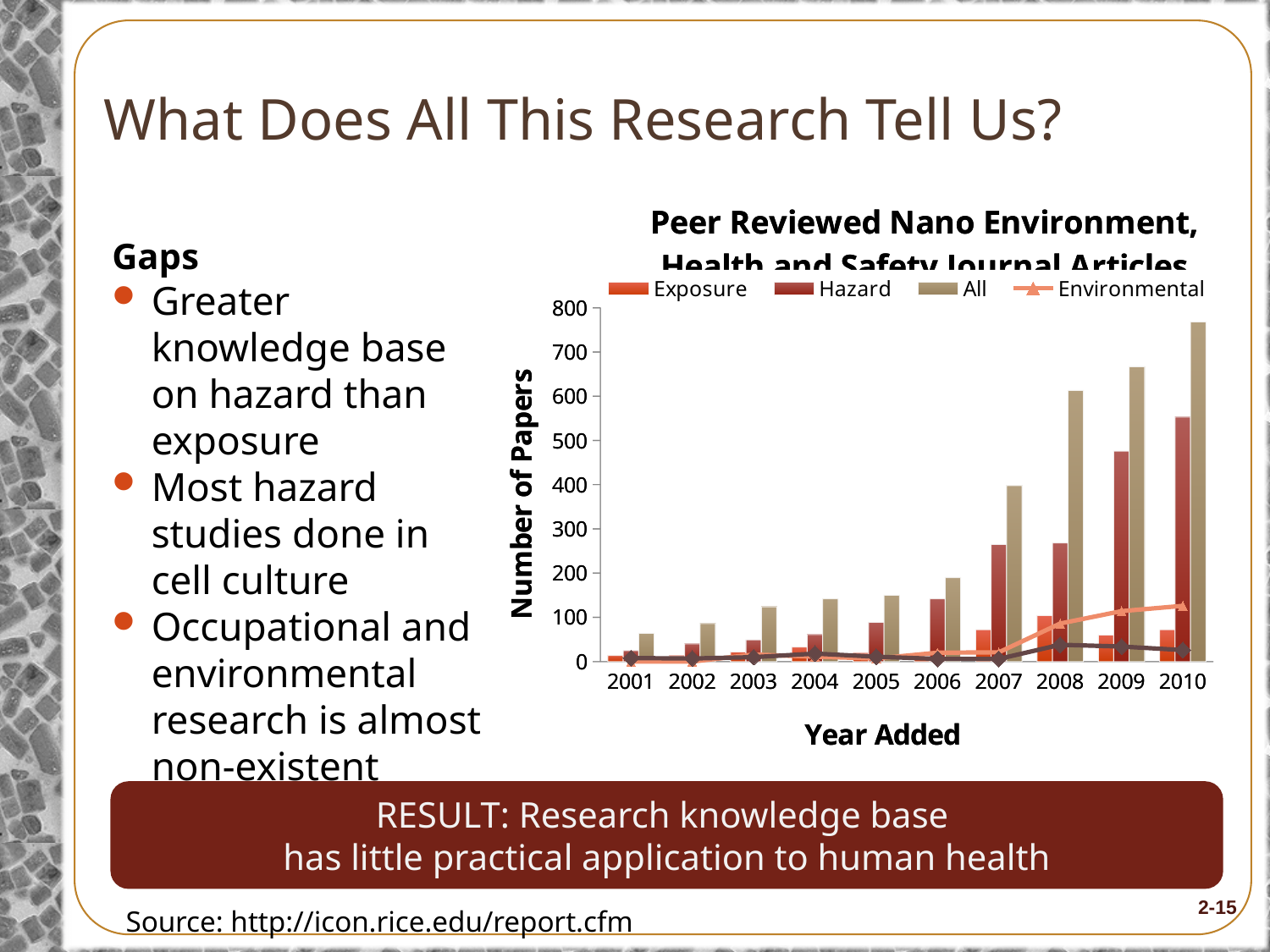
Is the 'All' value for 2010 greater or less than 700? greater Is the 'Exposure' value for 2010 greater or less than 100? less Do the 'All' values generally rise or fall from 2001 to 2010? rise Is the 'Hazard' value for 2010 greater or less than 500? greater In which year is the 'All' bar highest? 2010 In which year is the 'All' bar lowest? 2001 How many series does the chart's legend list? 4 In 2010, which is larger, the 'Hazard' bar or the 'Exposure' bar? Hazard What is the label on the chart's x axis? Year Added How many years are shown on the x axis of the chart? 10 What kind of chart is shown on the slide? bar chart with a line series